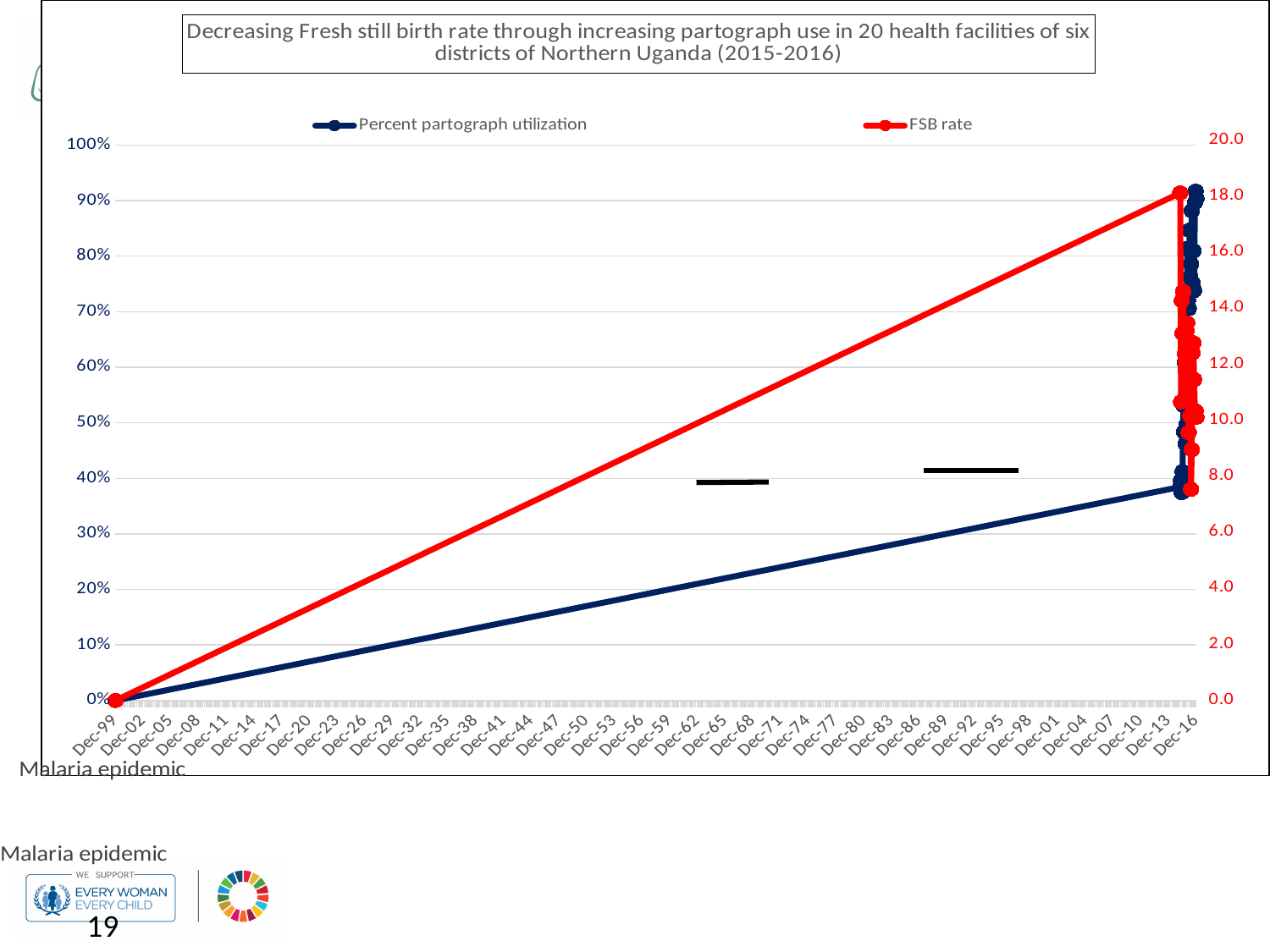
Is the highest Percent partograph utilization value greater or less than 80%? greater Does the FSB rate line rise or fall from Dec-99 to its peak near Dec-13? rise How many series does the legend list? 2 What is the FSB rate at Dec-99? 0.0 What is the lowest value of the FSB rate series? 0.0 What is the lowest value of the Percent partograph utilization series? 0% Which series is plotted against the right-hand axis (0.0 to 20.0)? FSB rate Is the highest FSB rate value greater or less than 16.0? greater What is the value of Percent partograph utilization at Dec-99? 0% What is the title of the chart? Decreasing Fresh still birth rate through increasing partograph use in 20 health facilities of six districts of Northern Uganda (2015-2016) What kind of chart is shown on the slide? line chart Does the Percent partograph utilization line rise or fall from Dec-99 to Dec-13? rise